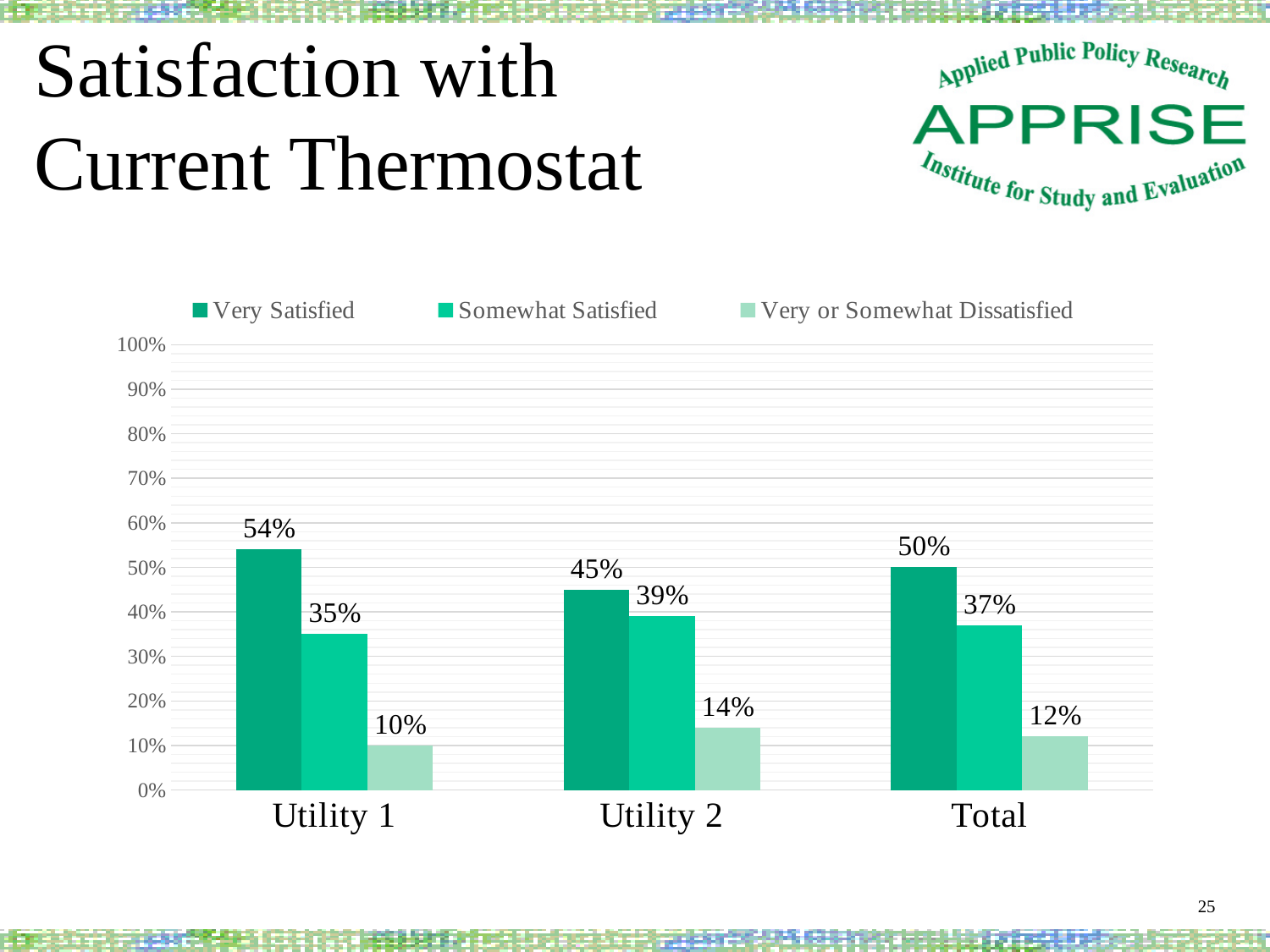
Is the Very Satisfied value for Total greater or less than 40%? greater What kind of chart is shown on the slide? Bar chart What is the title of the slide containing the chart? Satisfaction with Current Thermostat Which category has the lowest Very or Somewhat Dissatisfied value? Utility 1 Which is larger: the Somewhat Satisfied value for Utility 1 or for Utility 2? Utility 2 How many categories are shown on the x axis? 3 What percentage of Utility 1 respondents were Very Satisfied with their current thermostat? 54% Which category has the highest Very Satisfied value? Utility 1 What is the Somewhat Satisfied value for Utility 2? 39% What is the Very or Somewhat Dissatisfied value for Total? 12% What is the difference between the Very Satisfied values for Utility 1 and Utility 2? 9% How many series does the legend list? 3